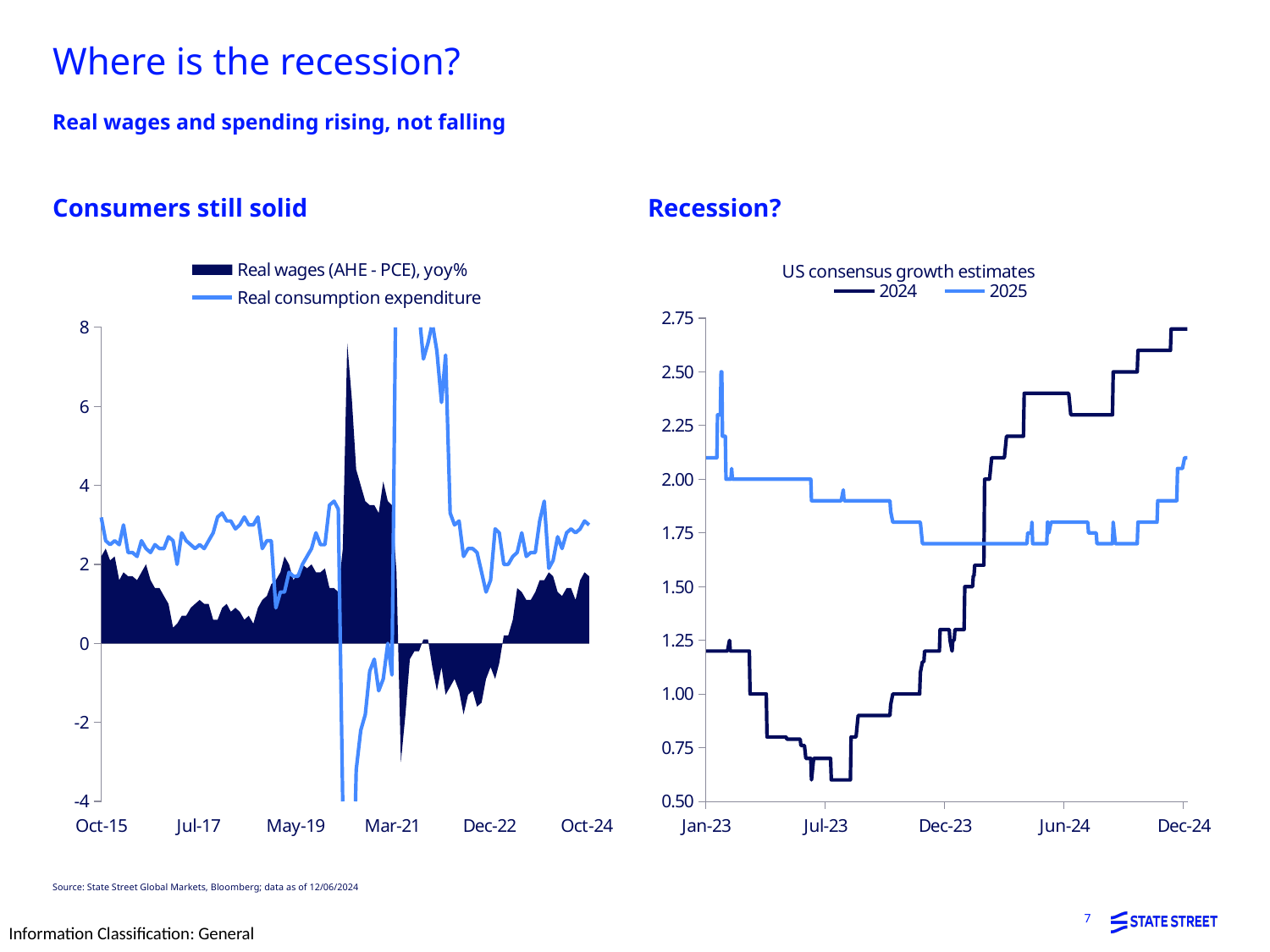
On the 'Consumers still solid' chart, how many series does the legend list? 2 On the 'Recession?' chart, which series is higher at Jan-23, 2024 or 2025? 2025 On the 'Recession?' chart, is the 2024 value at Jul-23 greater or less than 1.00? less On the 'Recession?' chart, how many series does the legend list? 2 What kind of chart is the 'Recession?' chart? line chart On the 'Consumers still solid' chart, which series is shown as a filled dark area? Real wages (AHE - PCE), yoy% On the 'Consumers still solid' chart, is the Real consumption expenditure value at Oct-24 greater or less than 2? greater On the 'Recession?' chart, does the 2024 series rise or fall overall from Jan-23 to Dec-24? rise What is the title printed above the legend of the right-hand chart? US consensus growth estimates On the 'Recession?' chart, is the 2024 value at Dec-24 greater or less than 2.50? greater On the 'Recession?' chart, which series is higher at Dec-24, 2024 or 2025? 2024